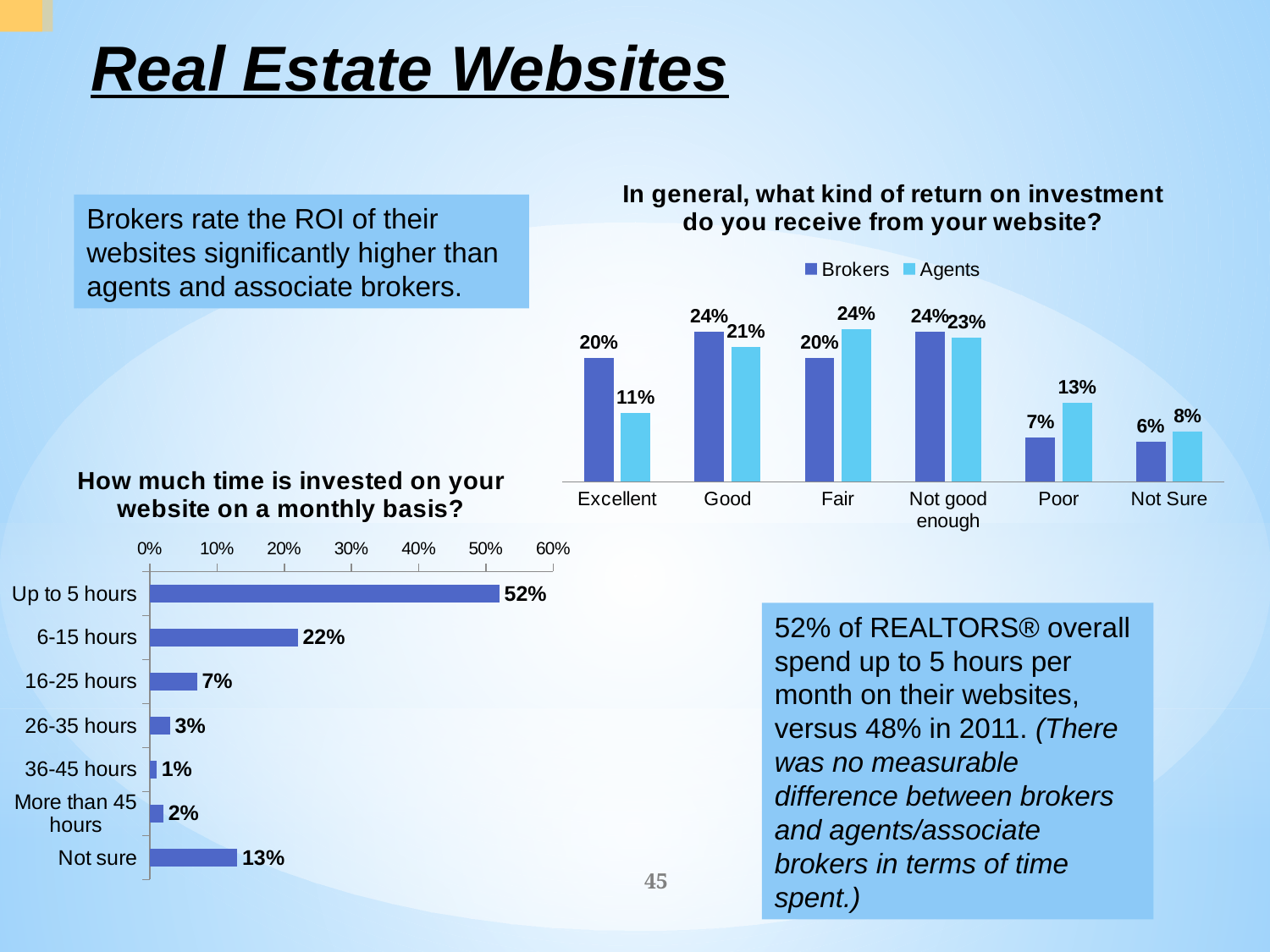
In the chart 'How much time is invested on your website on a monthly basis?', which category has the highest value? Up to 5 hours In the chart 'In general, what kind of return on investment do you receive from your website?', how many categories are shown on the x axis? 6 In the chart 'In general, what kind of return on investment do you receive from your website?', how many series does the legend list? 2 In the chart 'In general, what kind of return on investment do you receive from your website?', which category has the lowest value for Brokers? Not Sure In the chart 'In general, what kind of return on investment do you receive from your website?', is the Brokers value or the Agents value larger in the Fair category? Agents In the chart 'In general, what kind of return on investment do you receive from your website?', what is the difference between Brokers and Agents in the Excellent category? 9% In the chart 'In general, what kind of return on investment do you receive from your website?', what is the value for Brokers in the Excellent category? 20% What kind of chart is 'How much time is invested on your website on a monthly basis?'? Bar chart In the chart 'How much time is invested on your website on a monthly basis?', what is the difference between Up to 5 hours and Not sure? 39% In the chart 'How much time is invested on your website on a monthly basis?', what is the value for 6-15 hours? 22% In the chart 'In general, what kind of return on investment do you receive from your website?', what is the value for Agents in the Poor category? 13% In the chart 'How much time is invested on your website on a monthly basis?', which category has the lowest value? 36-45 hours